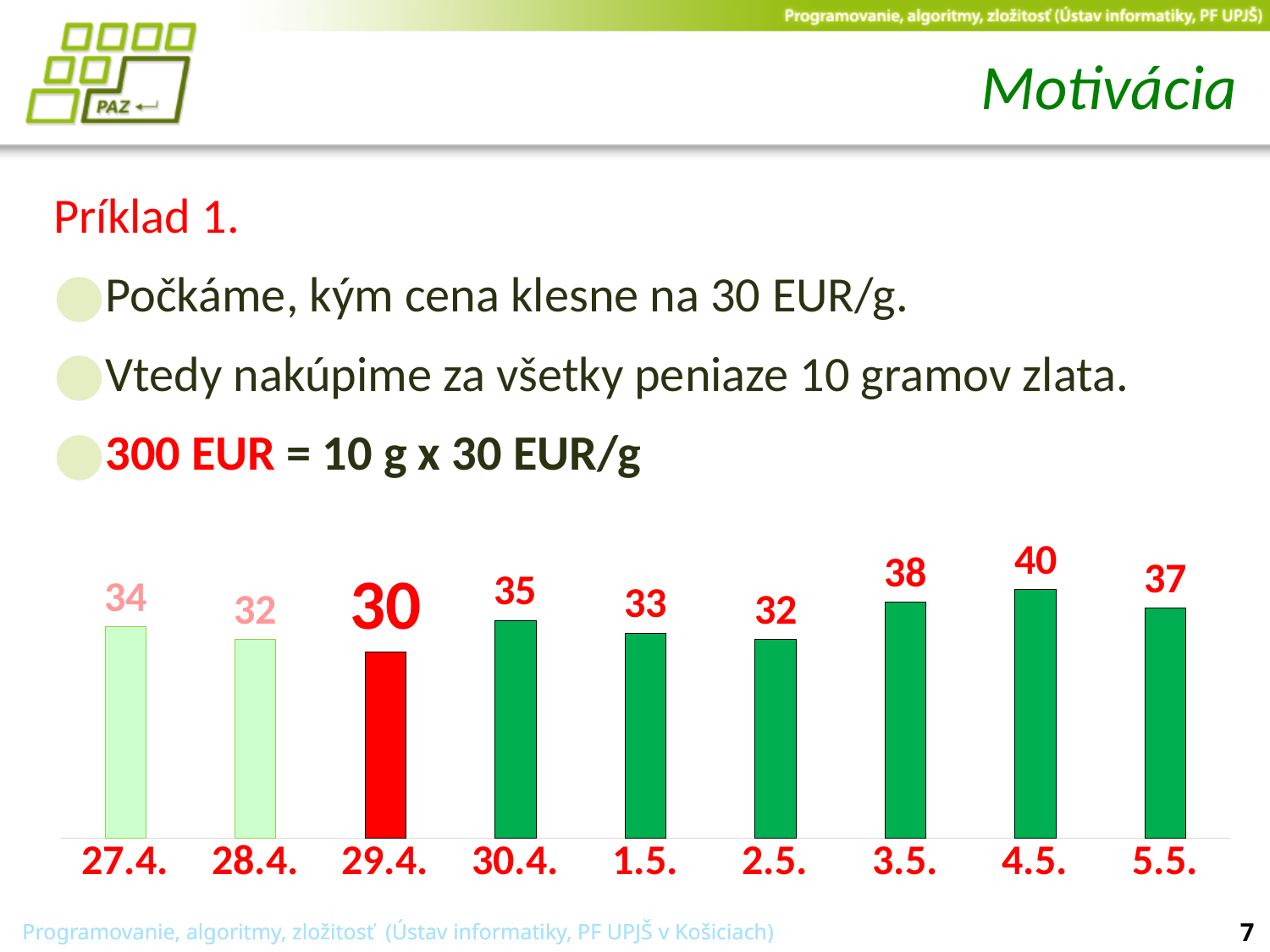
What is the value for 29.4.? 30 Which is larger, the value for 30.4. or the value for 1.5.? 30.4. Which date has the lowest value? 29.4. What is the difference between the values for 3.5. and 2.5.? 6 Which bar is coloured red? 29.4. Which date has the highest value? 4.5. What is the value for 27.4.? 34 What is the difference between the values for 4.5. and 29.4.? 10 What kind of chart is shown? bar chart Do the values rise or fall from 2.5. to 4.5.? rise What is the value for 4.5.? 40 How many dates are shown on the x axis? 9